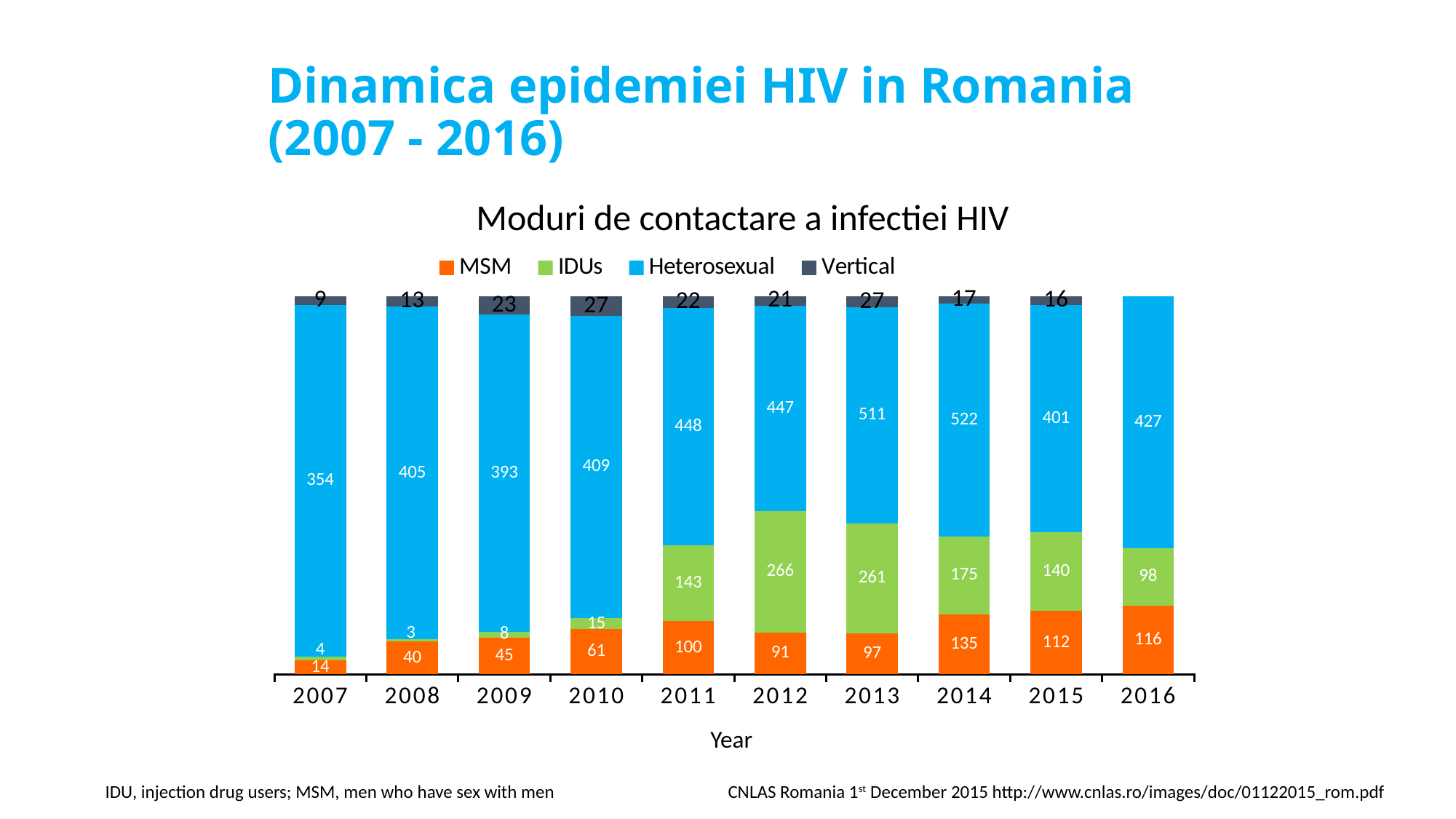
Which is larger, the IDUs value for 2013 or for 2014? 2013 How many series does the legend list? 4 What is the MSM value for 2010? 61 In which year is the Heterosexual value highest? 2014 What is the Heterosexual value for 2011? 448 What is the difference between the Heterosexual values for 2014 and 2015? 121 What is the IDUs value for 2012? 266 How many years are shown on the x axis? 10 What is the Vertical value for 2009? 23 What is the total of the stacked bar for 2007? 381 In which year is the IDUs value lowest? 2008 In which year is the MSM value highest? 2014